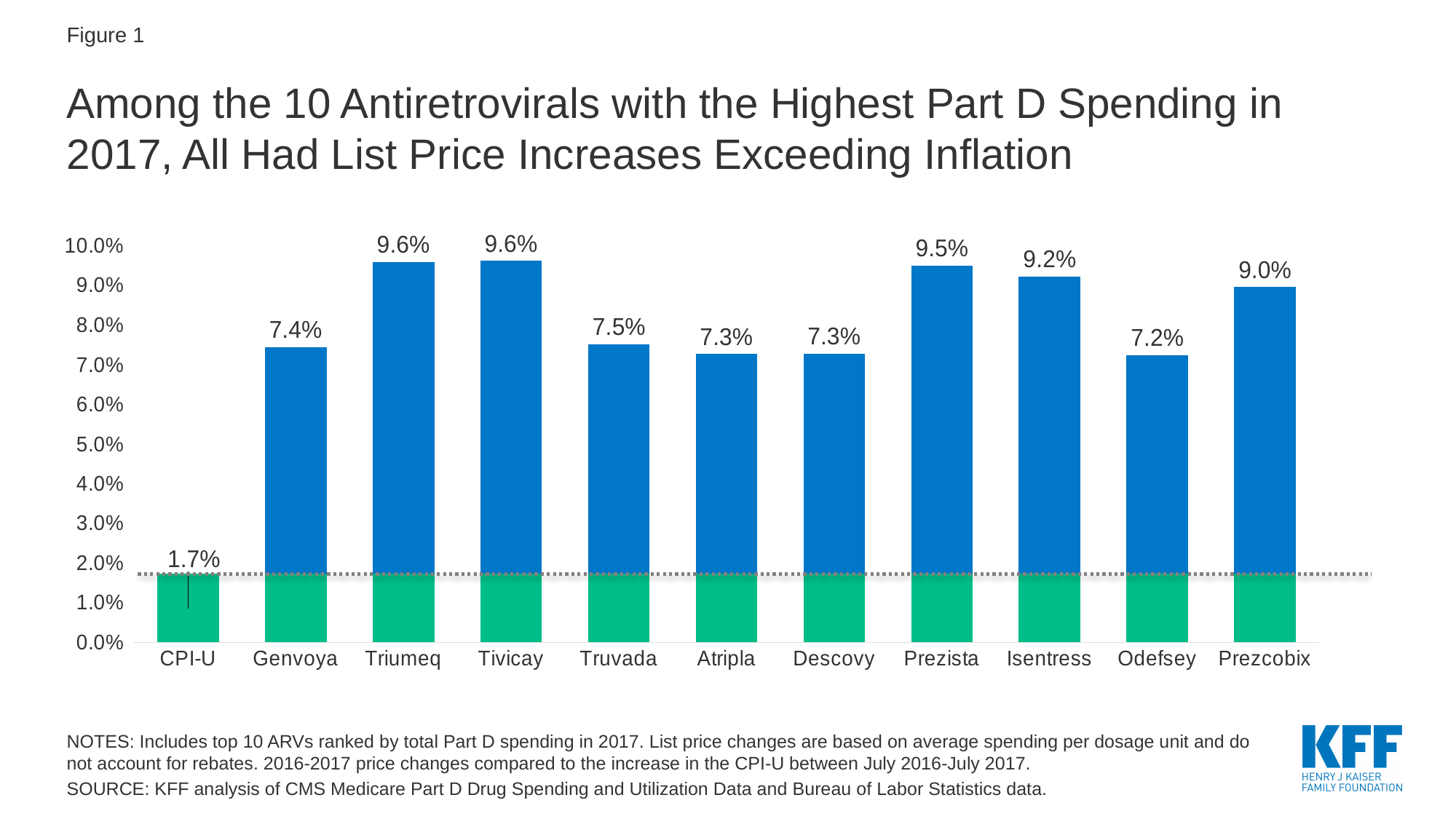
Which drug has the lowest value among the antiretrovirals? Odefsey What is the value shown for Genvoya? 7.4% What is the value shown for Isentress? 9.2% Which is larger, the value for Truvada or the value for Odefsey? Truvada Which category has the lowest value? CPI-U What does the dotted horizontal line across the chart mark? The CPI-U value (1.7%) What kind of chart is this? Bar chart What is the value shown for Prezcobix? 9.0% What is the difference between the values for Triumeq and Genvoya? 2.2% What is the value shown for CPI-U? 1.7% How many categories are shown on the x axis? 11 What is the difference between the values for Prezista and CPI-U? 7.8%